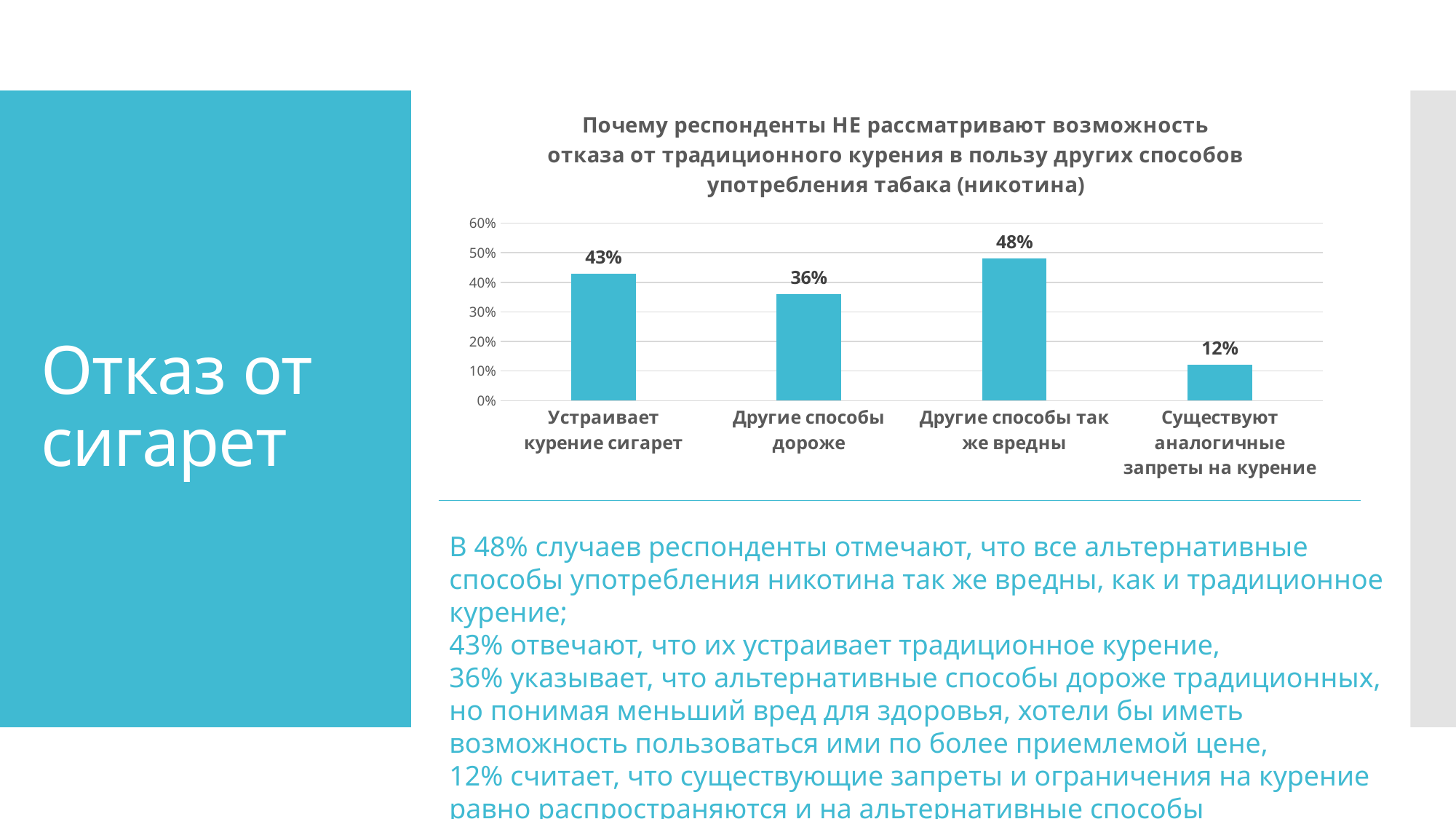
What is the value for "Другие способы дороже"? 36% What is the difference between the values for "Другие способы так же вредны" and "Устраивает курение сигарет"? 5% Which category has the highest value? Другие способы так же вредны What is the value for "Устраивает курение сигарет"? 43% What is the value for "Существуют аналогичные запреты на курение"? 12% Is the value for "Другие способы дороже" greater or less than 40%? less What is the maximum value shown on the vertical axis of the chart? 60% How many categories are shown in the chart? 4 What kind of chart is shown on the slide? bar chart Which is larger: the value for "Устраивает курение сигарет" or for "Другие способы дороже"? Устраивает курение сигарет What is the value for "Другие способы так же вредны"? 48% Which category has the lowest value? Существуют аналогичные запреты на курение